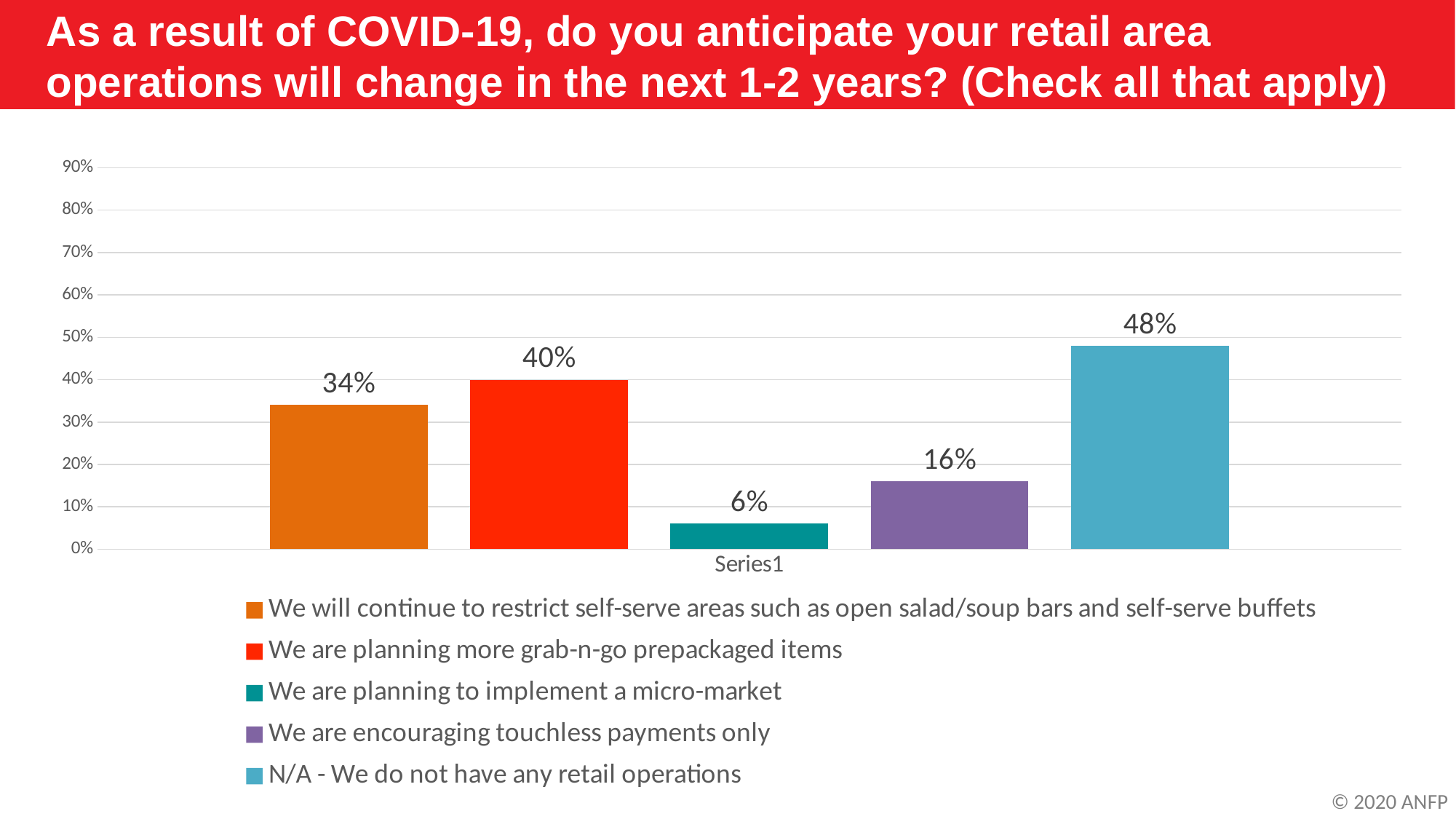
What type of chart is shown on the slide? Bar chart Which is larger: the percentage for continuing to restrict self-serve areas or the percentage for planning more grab-n-go prepackaged items? We are planning more grab-n-go prepackaged items How many response options are plotted as bars in the chart? 5 Which response option has the lowest percentage? We are planning to implement a micro-market Is the value for 'We are encouraging touchless payments only' greater or less than 20%? less What percentage of respondents are encouraging touchless payments only? 16% Which response option has the highest percentage? N/A - We do not have any retail operations What is the difference in percentage points between 'N/A - We do not have any retail operations' and 'We are planning more grab-n-go prepackaged items'? 8 percentage points What percentage of respondents said they will continue to restrict self-serve areas such as open salad/soup bars and self-serve buffets? 34% What percentage of respondents are planning to implement a micro-market? 6% What percentage of respondents are planning more grab-n-go prepackaged items? 40% What colour is the bar for 'We are planning to implement a micro-market'? Teal